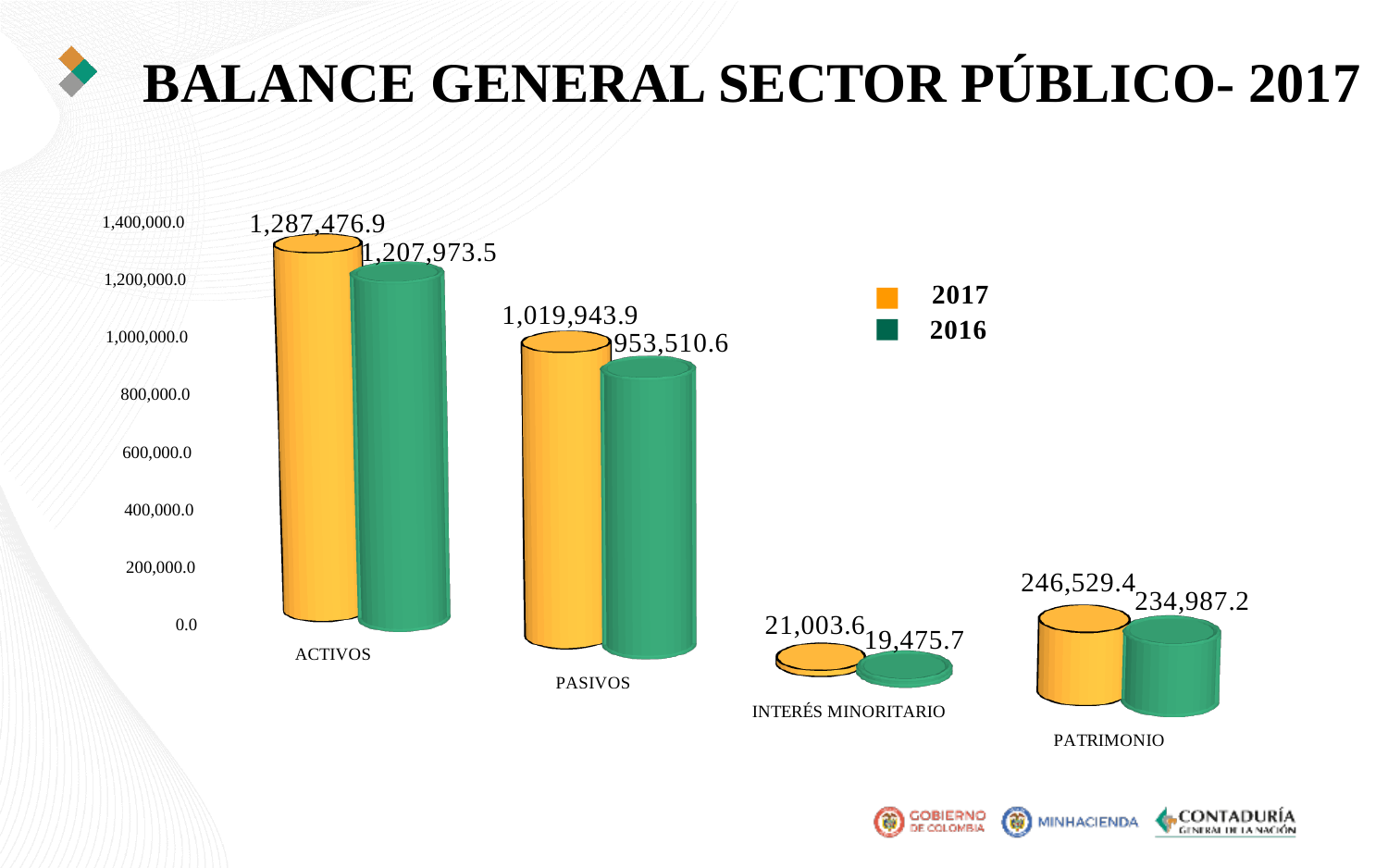
What is the difference between the 2017 and 2016 values for PATRIMONIO? 11,542.2 How many series does the legend list? 2 What is the 2016 value for PASIVOS? 953,510.6 What is the 2017 value for INTERÉS MINORITARIO? 21,003.6 What is the difference between the 2017 and 2016 values for ACTIVOS? 79,503.4 Which is larger, the 2017 value for PASIVOS or the 2016 value for ACTIVOS? 2016 value for ACTIVOS What is the 2016 value for PATRIMONIO? 234,987.2 What is the 2017 value for ACTIVOS? 1,287,476.9 Which category has the highest 2017 value? ACTIVOS Which category has the lowest 2016 value? INTERÉS MINORITARIO How many categories are shown on the x axis? 4 What kind of chart is shown on the slide? Bar chart